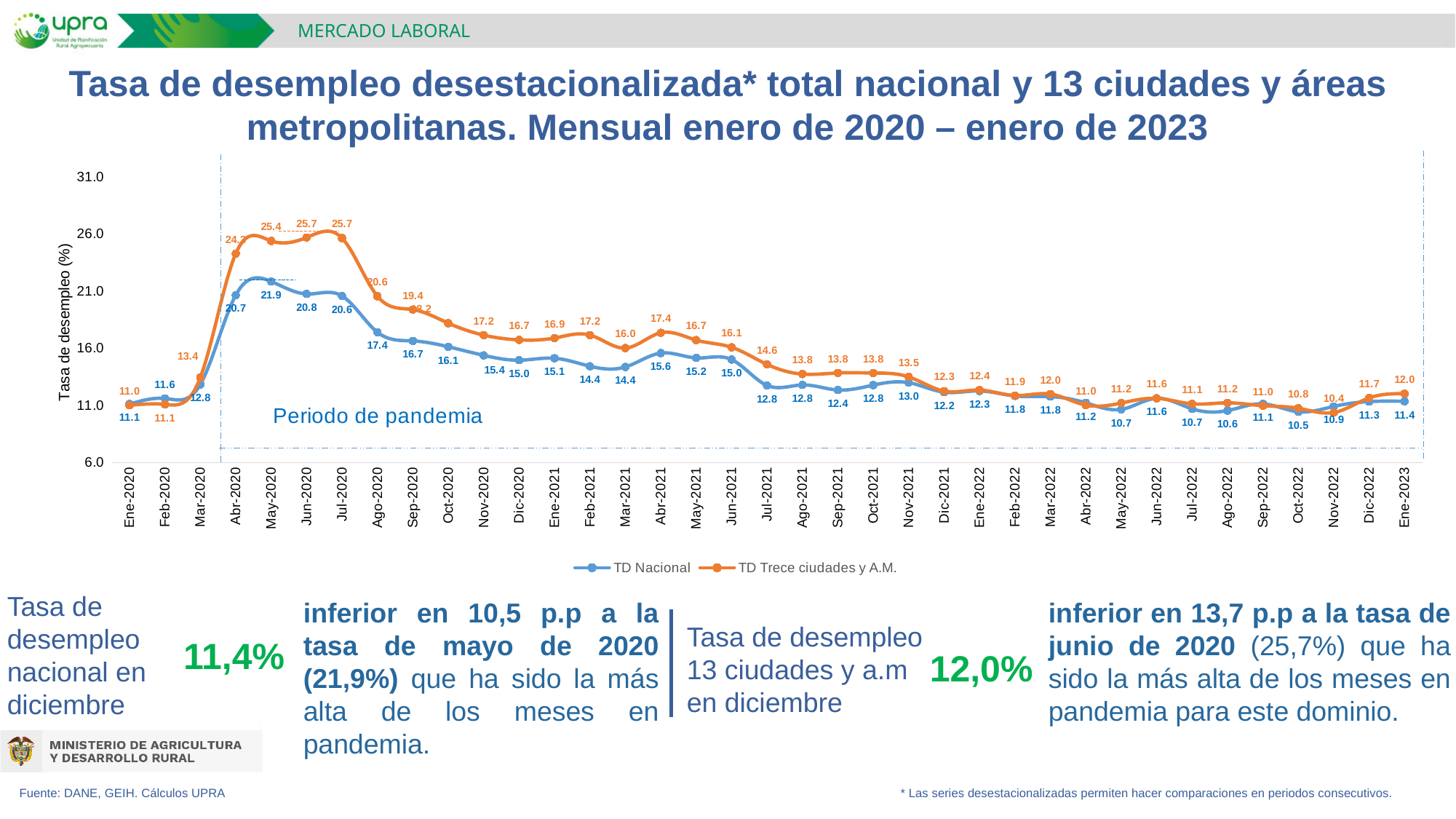
Which series has the higher value in Ago-2020, TD Nacional or TD Trece ciudades y A.M.? TD Trece ciudades y A.M. In which month does TD Trece ciudades y A.M. reach its lowest value? Nov-2022 What is the difference between TD Trece ciudades y A.M. and TD Nacional in Ene-2023? 0.6 What kind of chart is shown on the slide? Line chart What is the value of TD Nacional in Oct-2022? 10.5 How many months are plotted on the x axis? 37 How many series does the legend list? 2 In which month does TD Nacional reach its highest value? May-2020 What is the value of TD Nacional in Ene-2023? 11.4 What is the difference between TD Trece ciudades y A.M. and TD Nacional in May-2020? 3.5 What is the label of the y axis? Tasa de desempleo (%) What is the value of TD Trece ciudades y A.M. in Jul-2020? 25.7